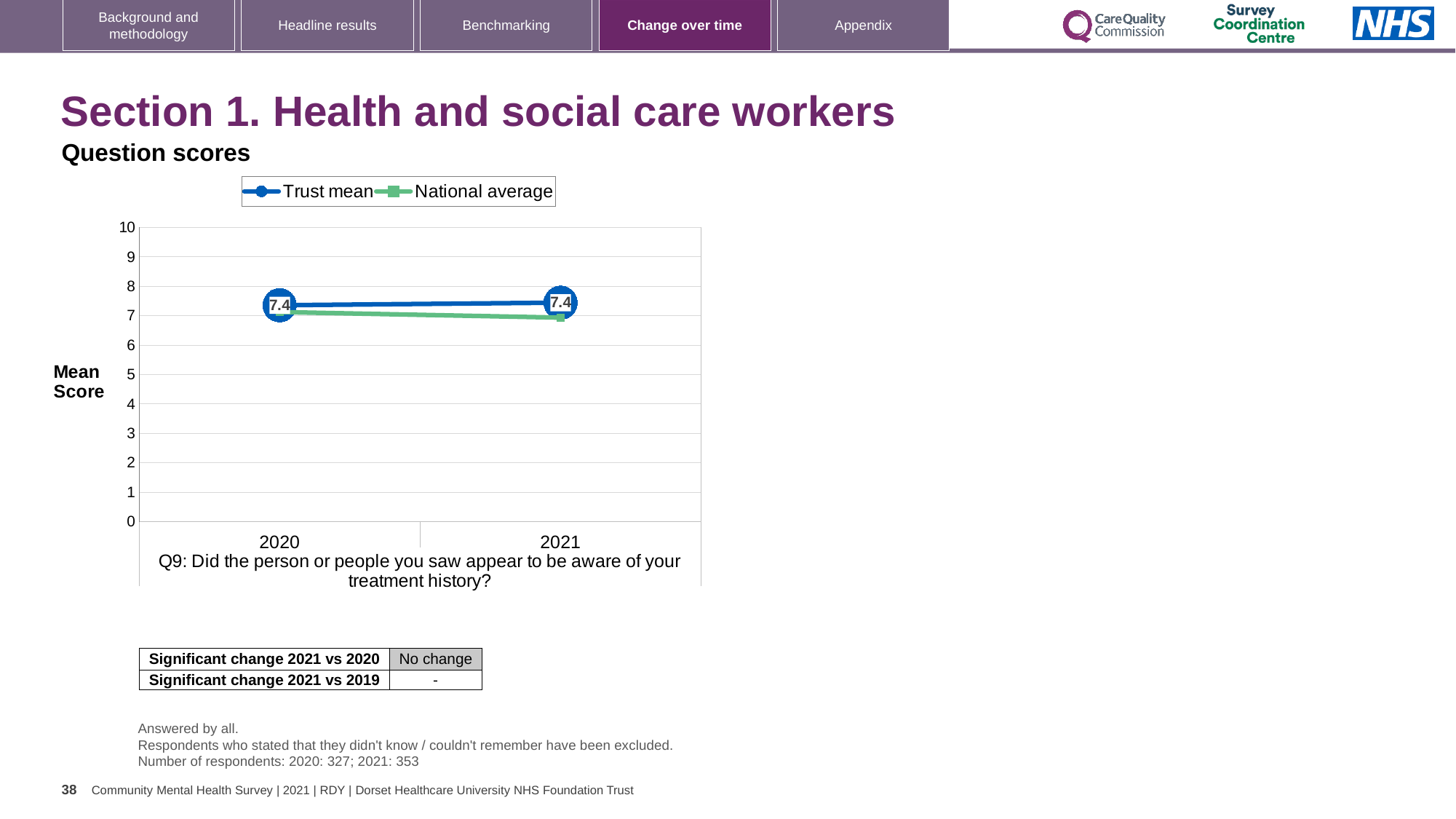
What is the difference between the Trust mean in 2021 and the Trust mean in 2020? 0 How many years are plotted on the x axis? 2 In 2021, which is larger: the Trust mean or the National average? Trust mean How many series does the legend list? 2 Does the Trust mean rise, fall or stay the same from 2020 to 2021? Stays the same What is the Trust mean score for 2021? 7.4 Is the National average for 2020 greater or less than 5? greater Is the National average for 2021 greater or less than 8? less What kind of chart is shown on the slide? Line chart What is the Trust mean score for 2020? 7.4 What are the two series named in the chart legend? Trust mean and National average What is the label on the vertical axis of the chart? Mean Score